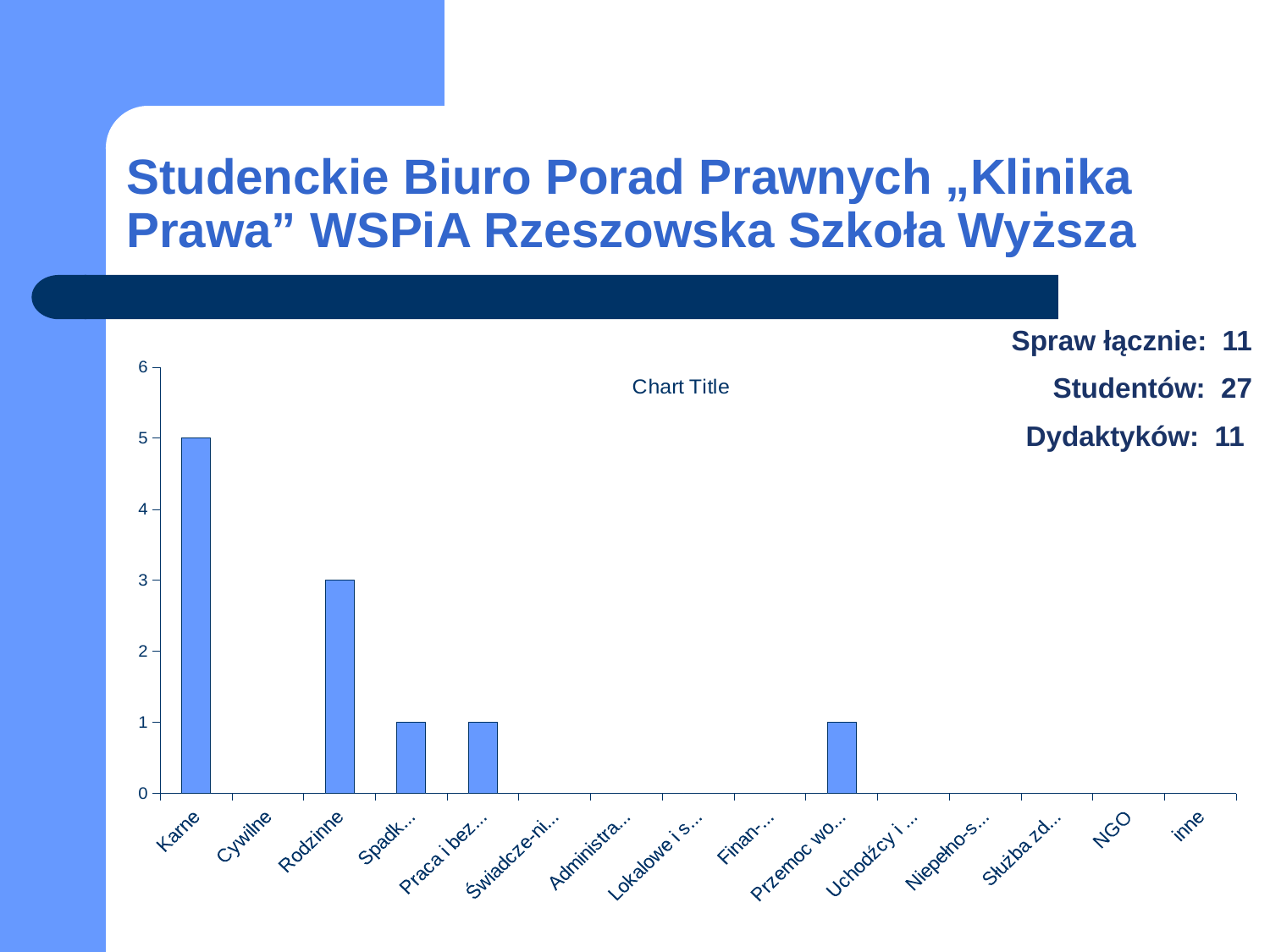
Is the value for Praca i bez... greater or less than 2? less How many categories are shown on the x axis? 15 What is the value for Przemoc wo...? 1 What is the title of the chart? Chart Title What is the value for Karne? 5 Which category has the highest value? Karne Is the value for Karne greater or less than 4? greater What is the highest value shown on the y axis? 6 What is the value for Rodzinne? 3 What type of chart is shown on the slide? bar chart What is the difference between the values for Karne and Rodzinne? 2 Which is larger, the value for Rodzinne or the value for Spadk...? Rodzinne